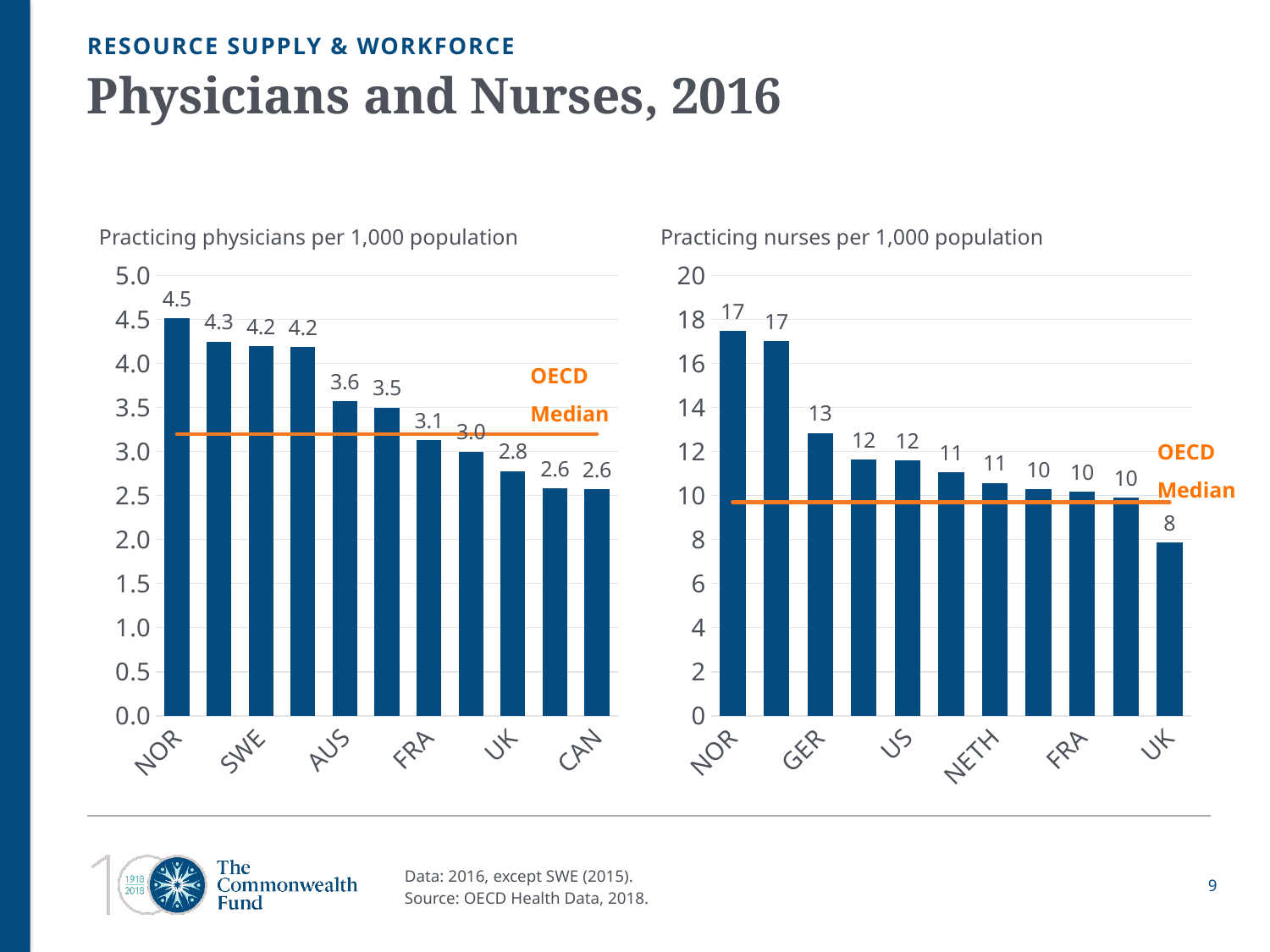
In the 'Practicing physicians per 1,000 population' chart, what is the difference between the values for NOR and CAN? 1.9 What does the orange horizontal line on each chart represent? OECD Median In the 'Practicing nurses per 1,000 population' chart, what is the value for GER? 13 How many bars are in the 'Practicing nurses per 1,000 population' chart? 11 In the 'Practicing physicians per 1,000 population' chart, what is the value for CAN? 2.6 In the 'Practicing nurses per 1,000 population' chart, what is the value for UK? 8 What kind of chart is the 'Practicing physicians per 1,000 population' chart? Bar chart In the 'Practicing nurses per 1,000 population' chart, which labeled country has the lowest value? UK In the 'Practicing physicians per 1,000 population' chart, which is larger, the value for AUS or the value for FRA? AUS In the 'Practicing physicians per 1,000 population' chart, which labeled country has the highest value? NOR In the 'Practicing physicians per 1,000 population' chart, what is the value for NOR? 4.5 In the 'Practicing nurses per 1,000 population' chart, do the values rise or fall from left to right? Fall